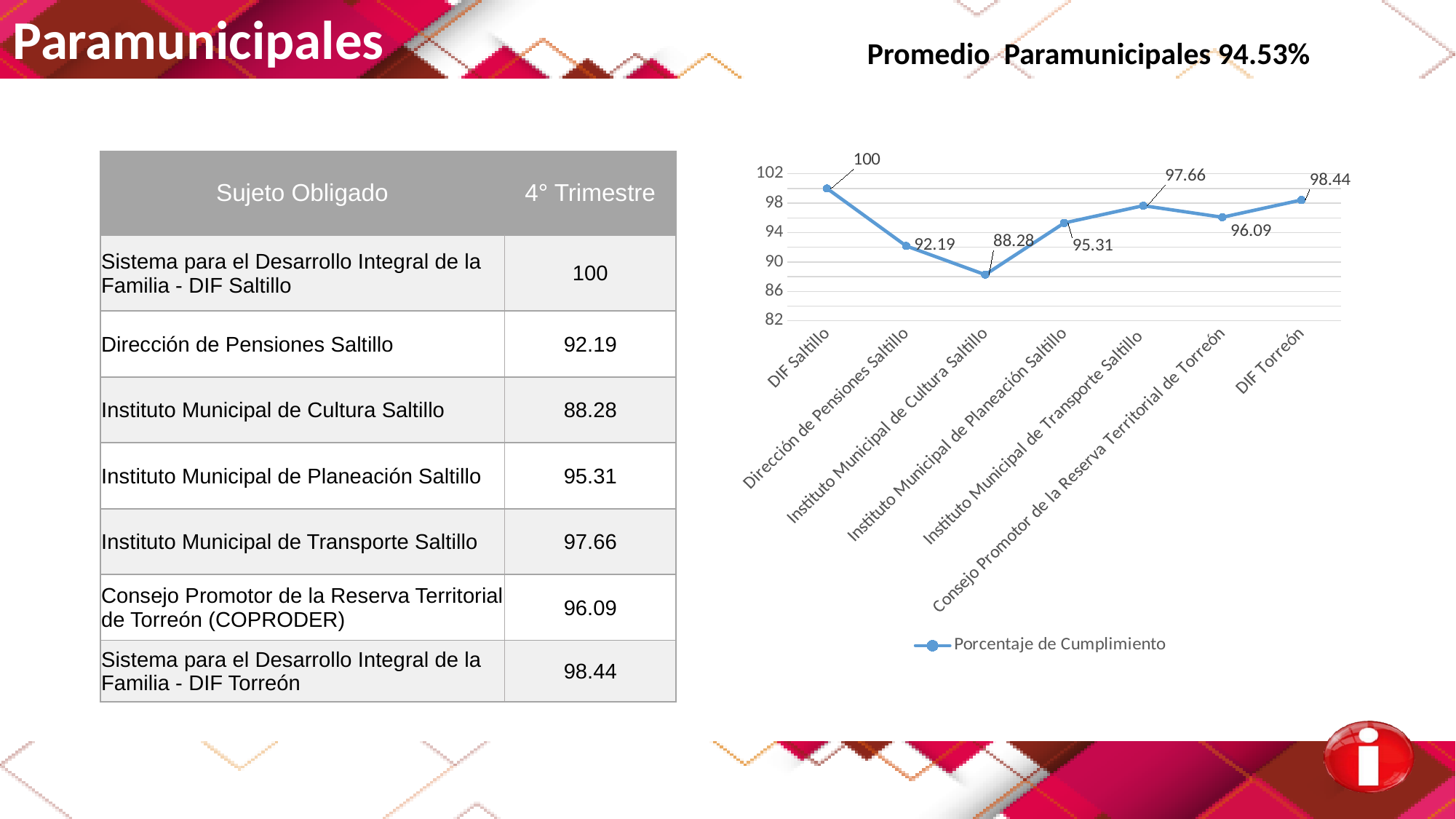
Which category has the lowest value in the chart? Instituto Municipal de Cultura Saltillo What is the name of the series shown in the chart legend? Porcentaje de Cumplimiento What type of chart is shown on the slide? line chart Which category has the highest value in the chart? DIF Saltillo What is the value for Consejo Promotor de la Reserva Territorial de Torreón in the chart? 96.09 Which is larger, the value for Instituto Municipal de Transporte Saltillo or the value for Instituto Municipal de Planeación Saltillo? Instituto Municipal de Transporte Saltillo How many categories are plotted on the x axis of the chart? 7 How many series does the chart legend list? 1 Is the value for Instituto Municipal de Cultura Saltillo greater or less than 90? less What is the difference between the values for DIF Torreón and Dirección de Pensiones Saltillo? 6.25 What is the value for DIF Saltillo in the chart? 100 What is the value for Instituto Municipal de Cultura Saltillo in the chart? 88.28